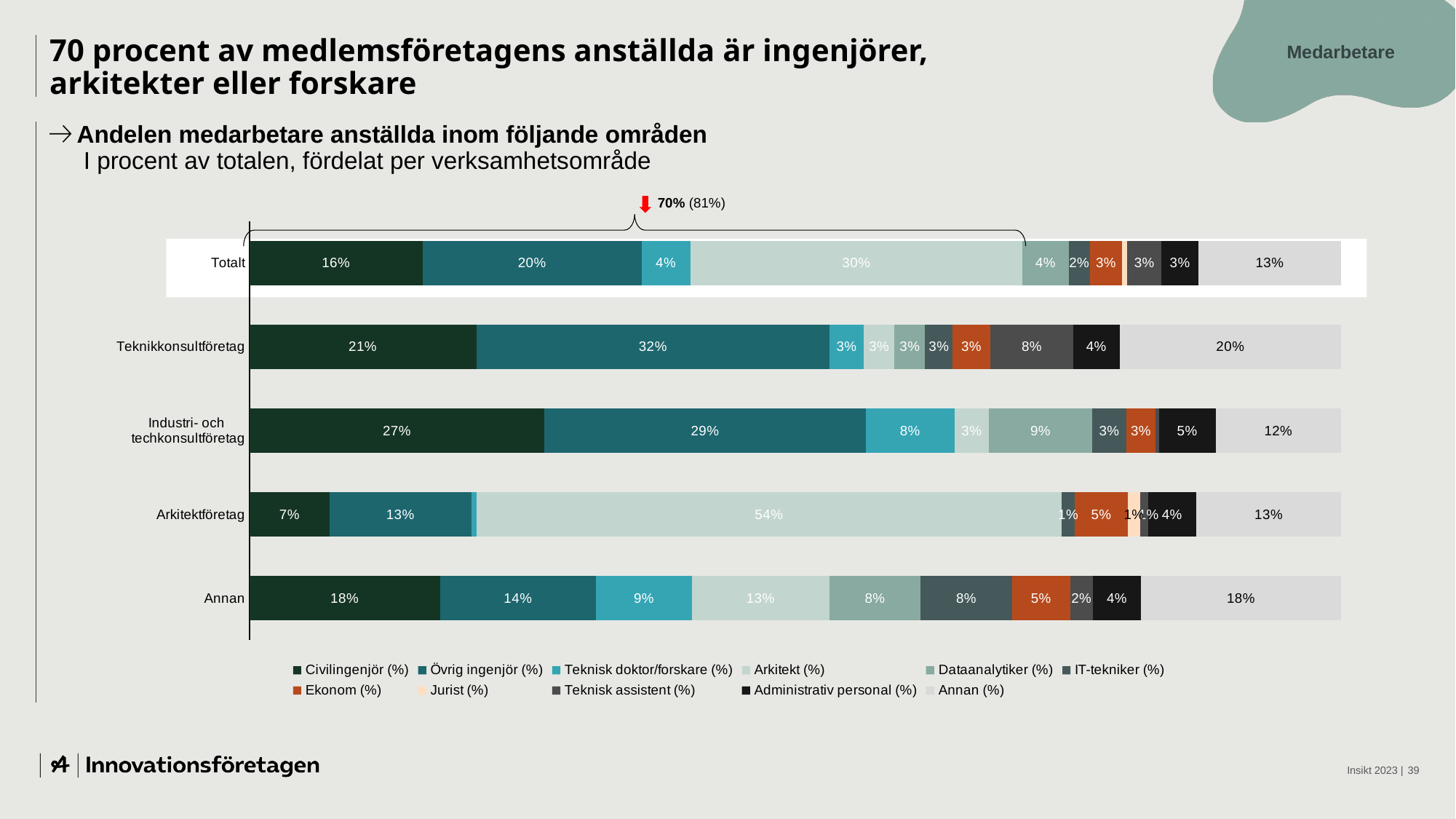
What is the difference between the Annan (%) share for Teknikkonsultföretag and for Industri- och techkonsultföretag? 8 percentage points What is the Dataanalytiker (%) share for Industri- och techkonsultföretag? 9% Which has a larger Övrig ingenjör (%) share, Totalt or Annan? Totalt Which category has the highest Civilingenjör (%) share? Industri- och techkonsultföretag What is the Övrig ingenjör (%) share for Teknikkonsultföretag? 32% What annotation is shown above the Totalt bar? 70% (81%) What kind of chart is shown on the slide? Stacked bar chart How many series does the legend list? 11 How many categories (bars) are shown in the chart? 5 Which category has the lowest Civilingenjör (%) share? Arkitektföretag What is the Civilingenjör (%) share for Industri- och techkonsultföretag? 27% What is the Arkitekt (%) share for Arkitektföretag? 54%